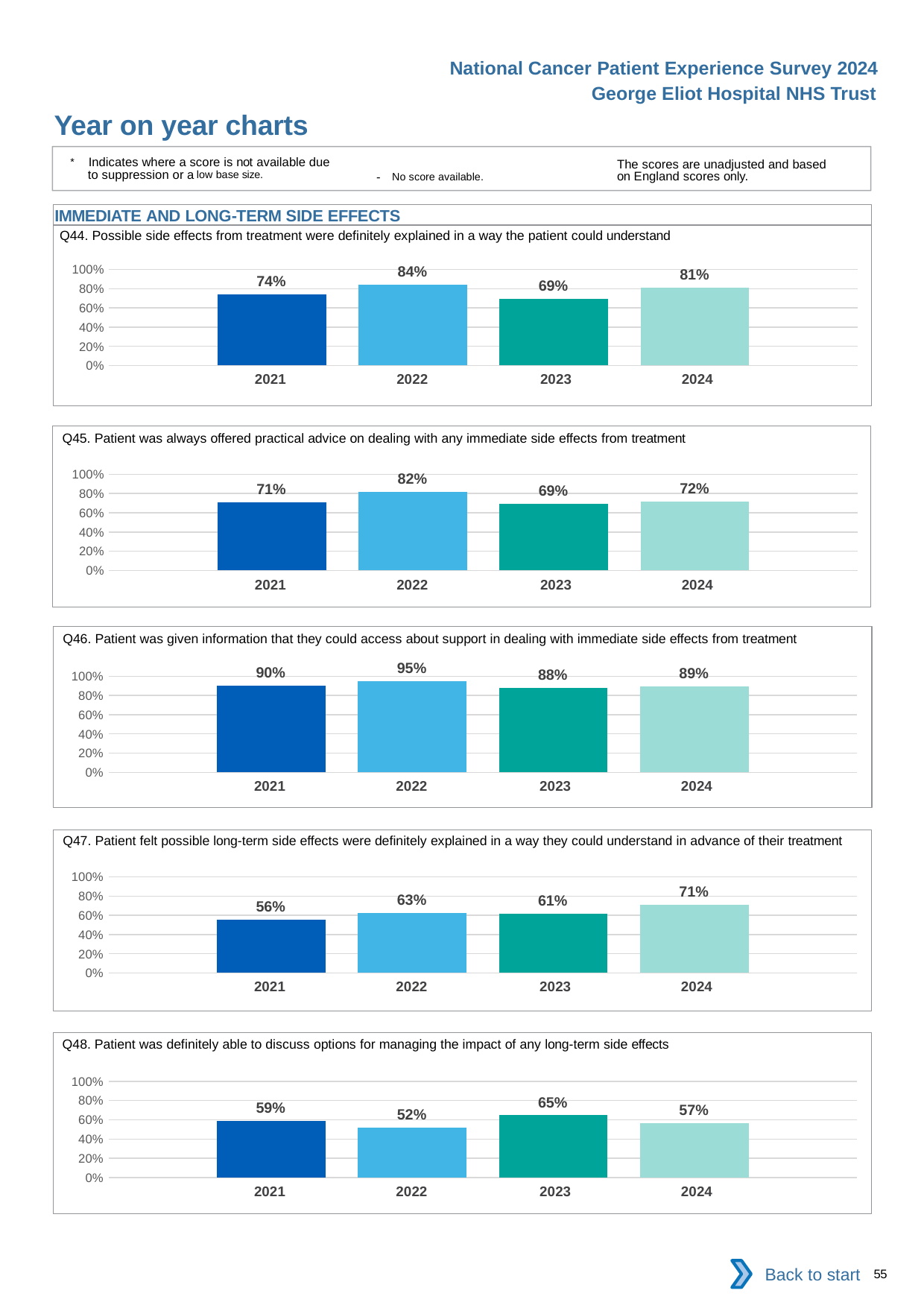
In the Q44 chart, which year has the lowest value? 2023 What type of chart is used for Q44? bar chart In the Q46 chart, which year has the highest value? 2022 In the Q47 chart, do the values rise or fall from 2021 to 2024 overall? rise In the Q45 chart, what is the value for 2024? 72% In the Q46 chart, what is the value for 2023? 88% In the Q47 chart, what is the difference between the 2024 and 2021 values? 15 percentage points In the Q45 chart, what is the difference between the 2022 and 2023 values? 13 percentage points In the Q44 chart, what is the value for 2022? 84% In the Q48 chart, which is larger, the value for 2021 or the value for 2024? 2021 How many years are shown in the Q48 chart? 4 In the Q48 chart, what is the value for 2022? 52%